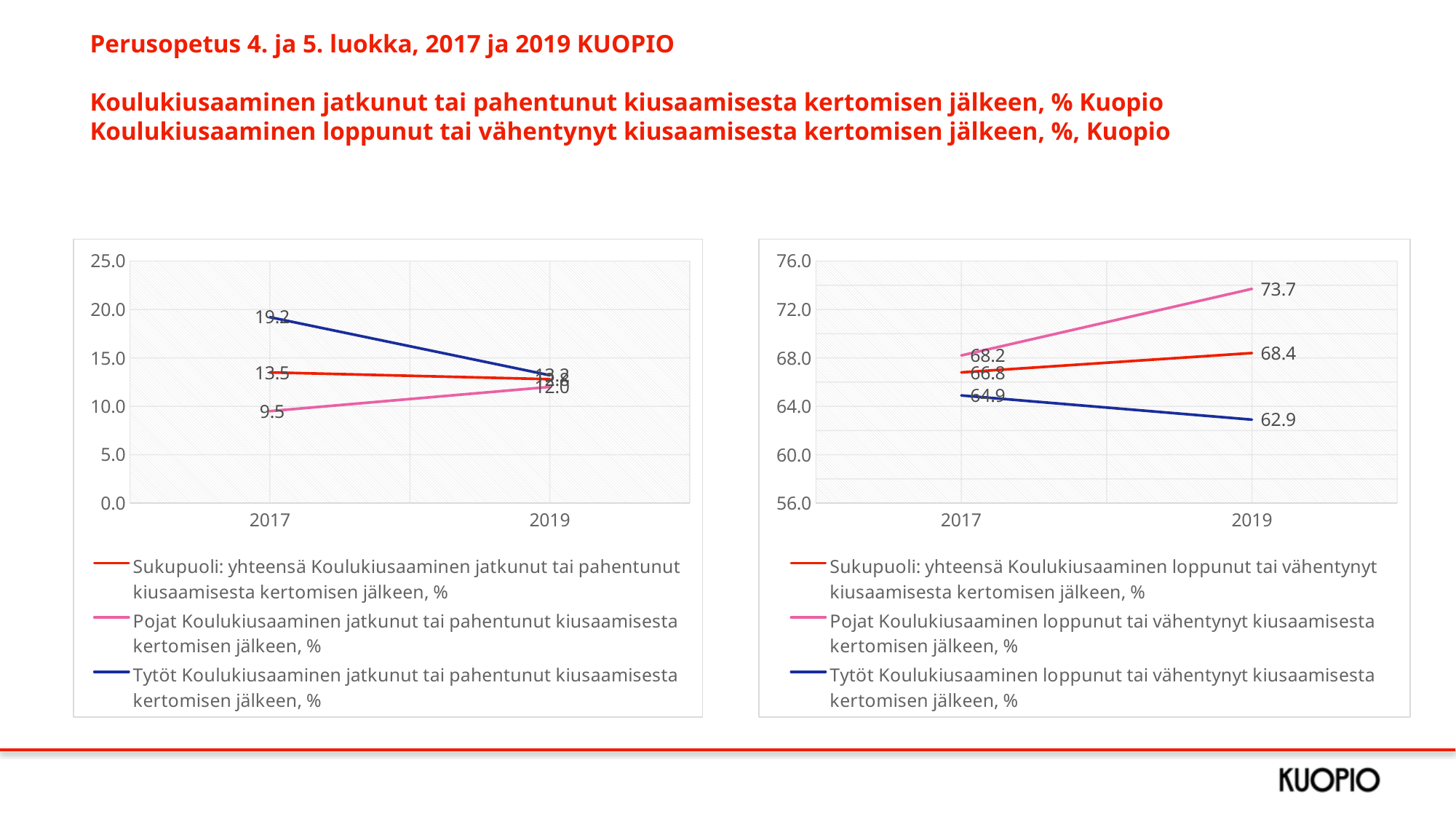
In the right chart (Koulukiusaaminen loppunut tai vähentynyt), which series has the lowest value in 2019? Tytöt In the right chart (Koulukiusaaminen loppunut tai vähentynyt), what is the value for Pojat in 2019? 73.7 In the right chart (Koulukiusaaminen loppunut tai vähentynyt), what is the value for Sukupuoli: yhteensä in 2019? 68.4 In the left chart (Koulukiusaaminen jatkunut tai pahentunut), what is the value for Pojat in 2017? 9.5 In the right chart (Koulukiusaaminen loppunut tai vähentynyt), what is the value for Tytöt in 2017? 64.9 How many series does the legend of the right chart list? 3 In the right chart (Koulukiusaaminen loppunut tai vähentynyt), by how much did the Pojat value change from 2017 to 2019? 5.5 In the right chart (Koulukiusaaminen loppunut tai vähentynyt), does the Tytöt series rise or fall from 2017 to 2019? fall In the left chart (Koulukiusaaminen jatkunut tai pahentunut), is the value for Tytöt in 2019 greater or less than 15.0? less In the left chart (Koulukiusaaminen jatkunut tai pahentunut), what is the value for Tytöt in 2017? 19.2 What kind of chart is the left chart? line chart In the left chart (Koulukiusaaminen jatkunut tai pahentunut), which series has the highest value in 2017? Tytöt